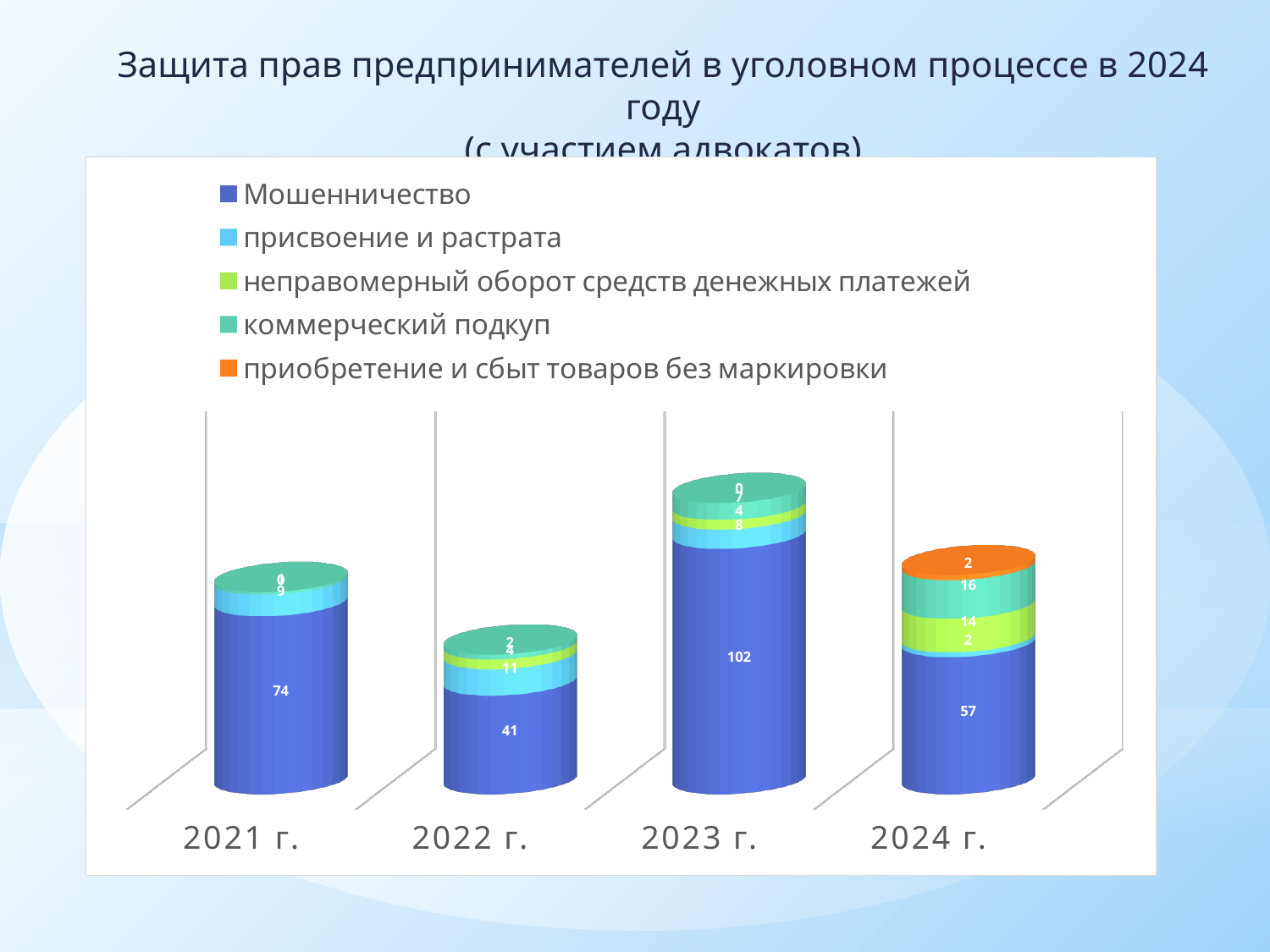
What is the value for неправомерный оборот средств денежных платежей in 2024 г.? 14 How many series does the legend list? 5 In which year is the value for Мошенничество the highest? 2023 г. What is the difference between the Мошенничество values for 2023 г. and 2022 г.? 61 What is the value for Мошенничество in 2022 г.? 41 What is the value for коммерческий подкуп in 2024 г.? 16 Which is larger, the Мошенничество value for 2021 г. or for 2024 г.? 2021 г. In which year is the value for Мошенничество the lowest? 2022 г. What is the value for Мошенничество in 2023 г.? 102 What is the value for присвоение и растрата in 2022 г.? 11 What is the total of the stacked bar for 2024 г.? 91 How many years are shown on the x axis? 4